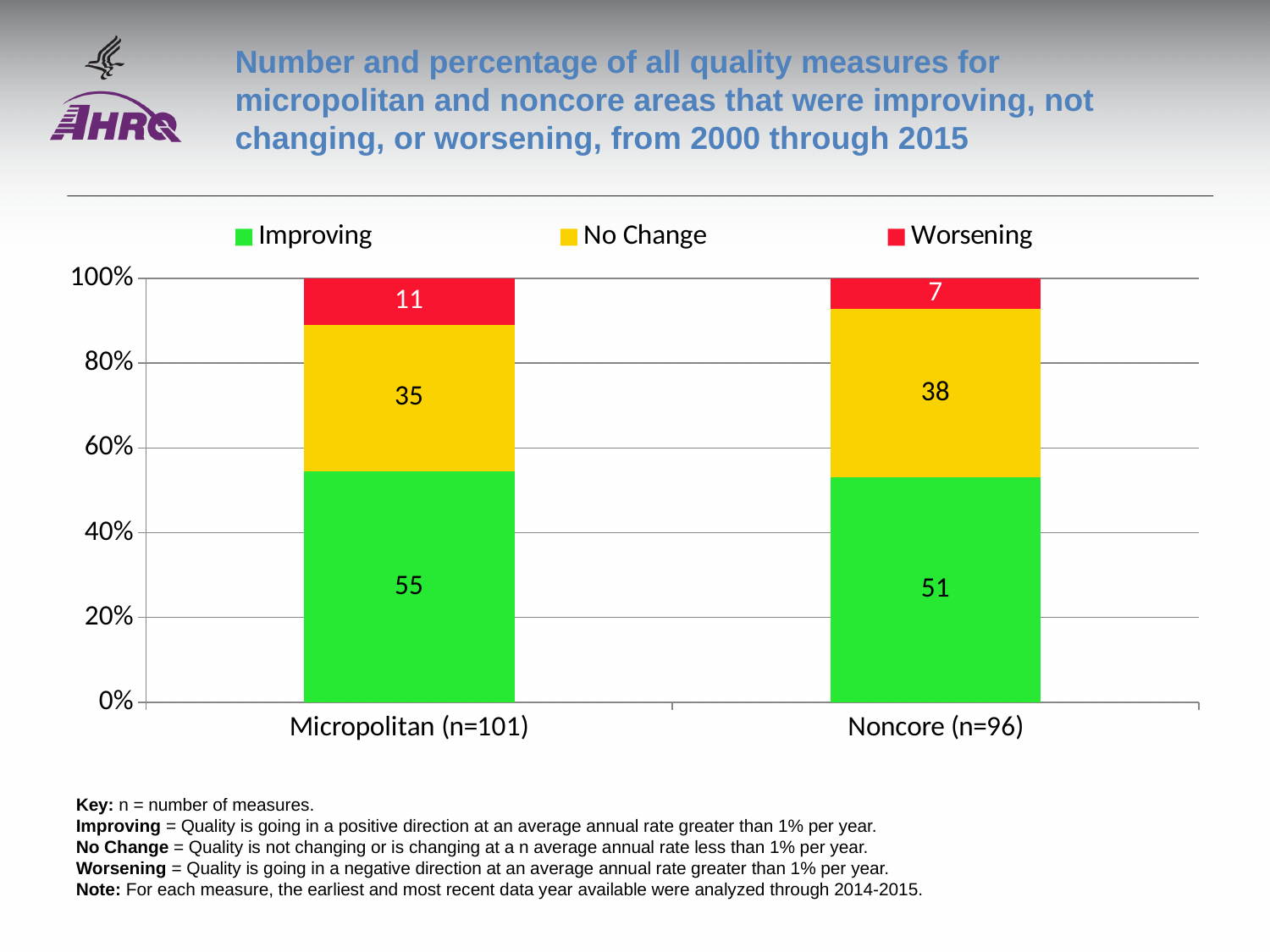
How many quality measures showed no change in Noncore areas (n=96)? 38 How many series does the legend list? 3 What is the total number of measures in the Micropolitan bar? 101 What is the difference between the number of improving measures in Micropolitan and Noncore areas? 4 How many quality measures were improving in Micropolitan areas (n=101)? 55 How many quality measures were worsening in Noncore areas (n=96)? 7 Which area has more improving measures, Micropolitan or Noncore? Micropolitan What is the difference between the number of worsening measures in Micropolitan and Noncore areas? 4 What kind of chart is shown on the slide? Stacked bar chart How many quality measures were worsening in Micropolitan areas (n=101)? 11 How many categories are shown on the x axis? 2 What is the total number of measures in the Noncore bar? 96